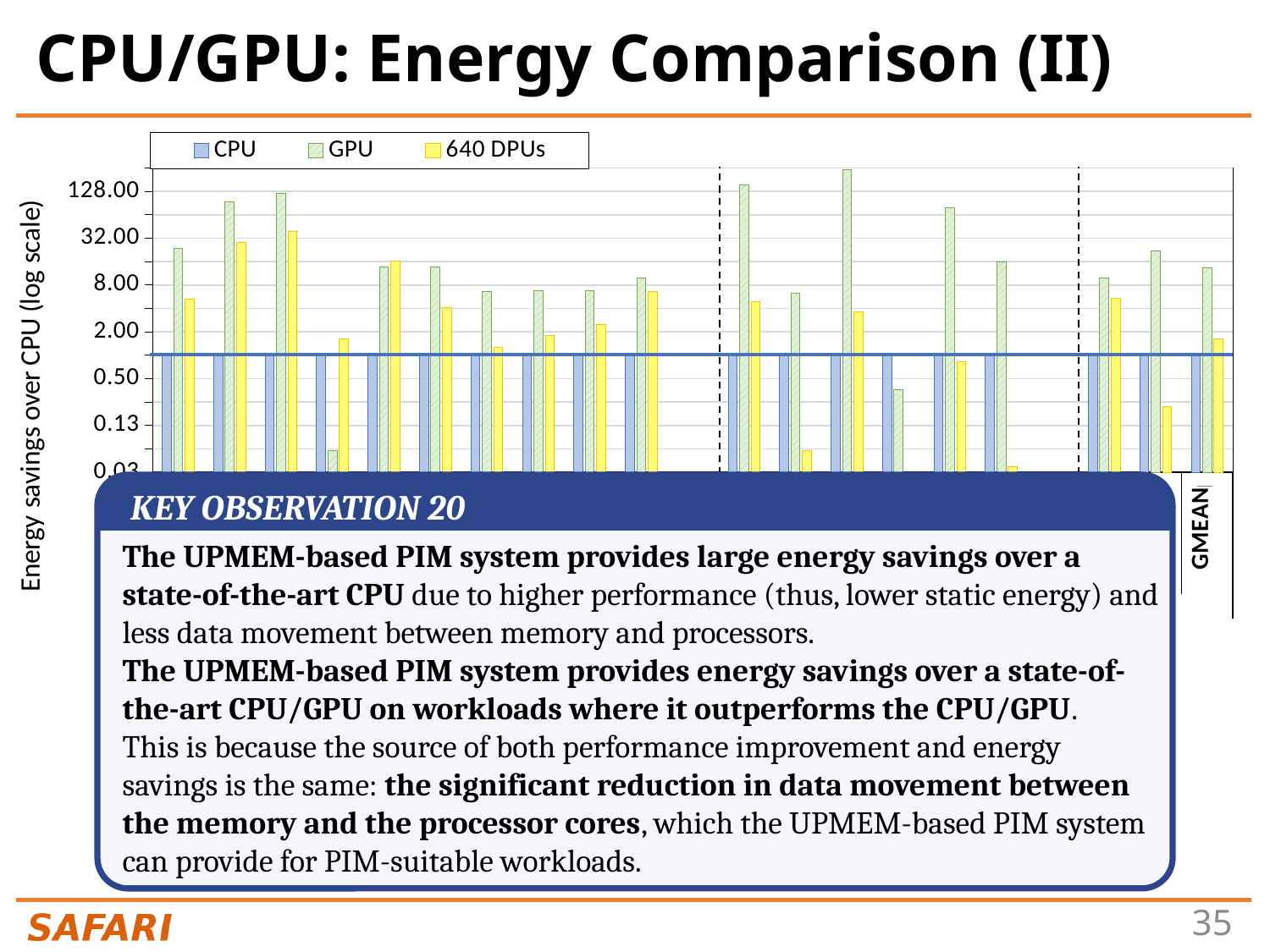
What is the label of the chart's vertical axis? Energy savings over CPU (log scale) Is the 640 DPUs value for GMEAN greater or less than 0.50? greater For GMEAN, which series has the highest value? GPU Is the GPU value for GMEAN greater or less than 32.00? less Is the 640 DPUs value for GMEAN greater or less than 2.00? less For GMEAN, which is larger: the GPU value or the 640 DPUs value? GPU What kind of chart is shown on the slide? bar chart What are the three series named in the chart legend? CPU, GPU, 640 DPUs How many series does the chart legend list? 3